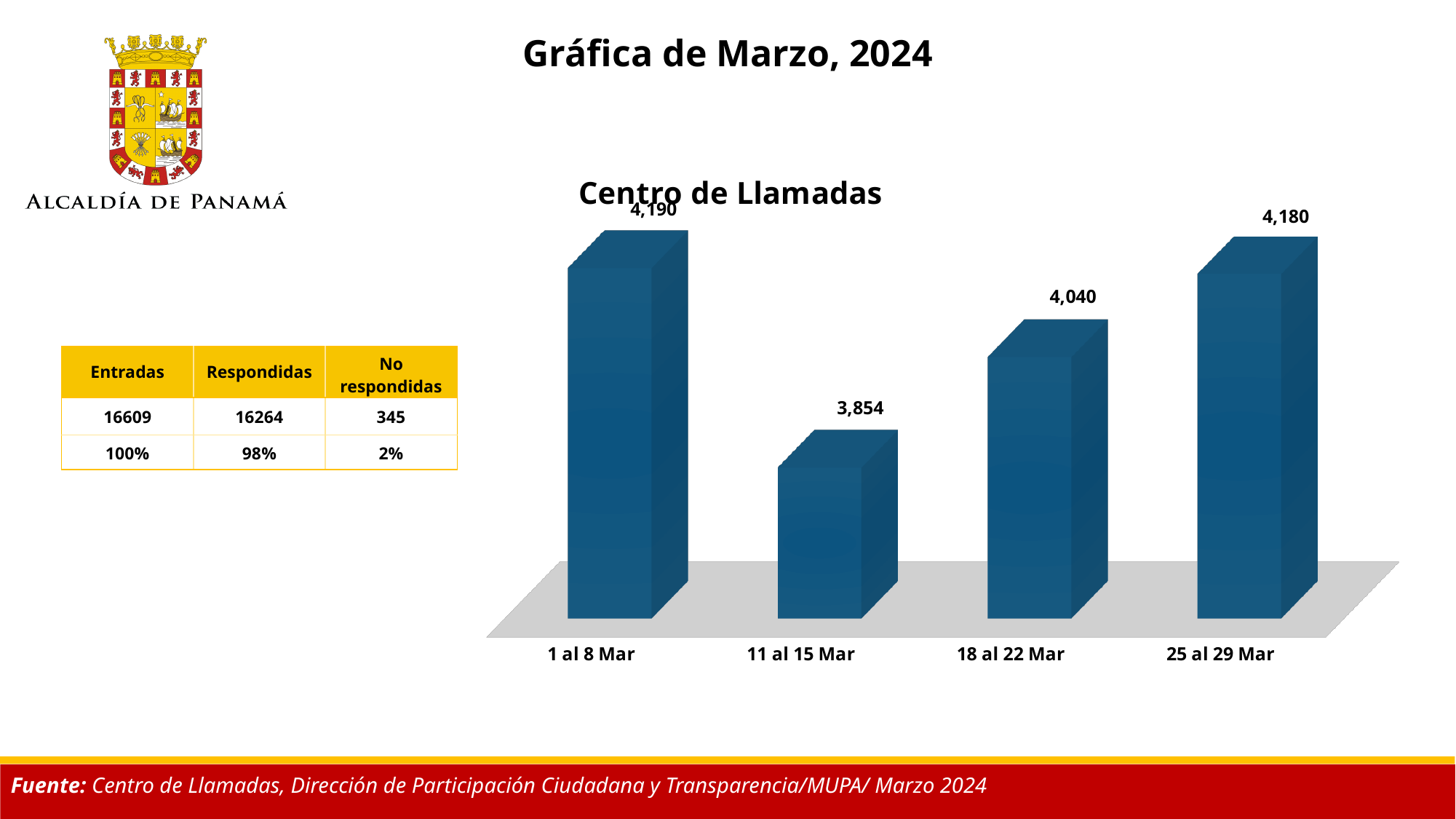
What is the difference between the values for 1 al 8 Mar and 11 al 15 Mar? 336 What is the value for 11 al 15 Mar in the Centro de Llamadas chart? 3,854 How many periods are shown in the Centro de Llamadas chart? 4 Which period has the lowest value in the Centro de Llamadas chart? 11 al 15 Mar Which is larger, the value for 18 al 22 Mar or the value for 11 al 15 Mar? 18 al 22 Mar What is the title of the chart on the slide? Centro de Llamadas What is the difference between the values for 25 al 29 Mar and 18 al 22 Mar? 140 What is the value for 25 al 29 Mar in the Centro de Llamadas chart? 4,180 Which period has the highest value in the Centro de Llamadas chart? 1 al 8 Mar What is the value for 18 al 22 Mar in the Centro de Llamadas chart? 4,040 What is the value for 1 al 8 Mar in the Centro de Llamadas chart? 4,190 What kind of chart is the Centro de Llamadas chart? Bar chart